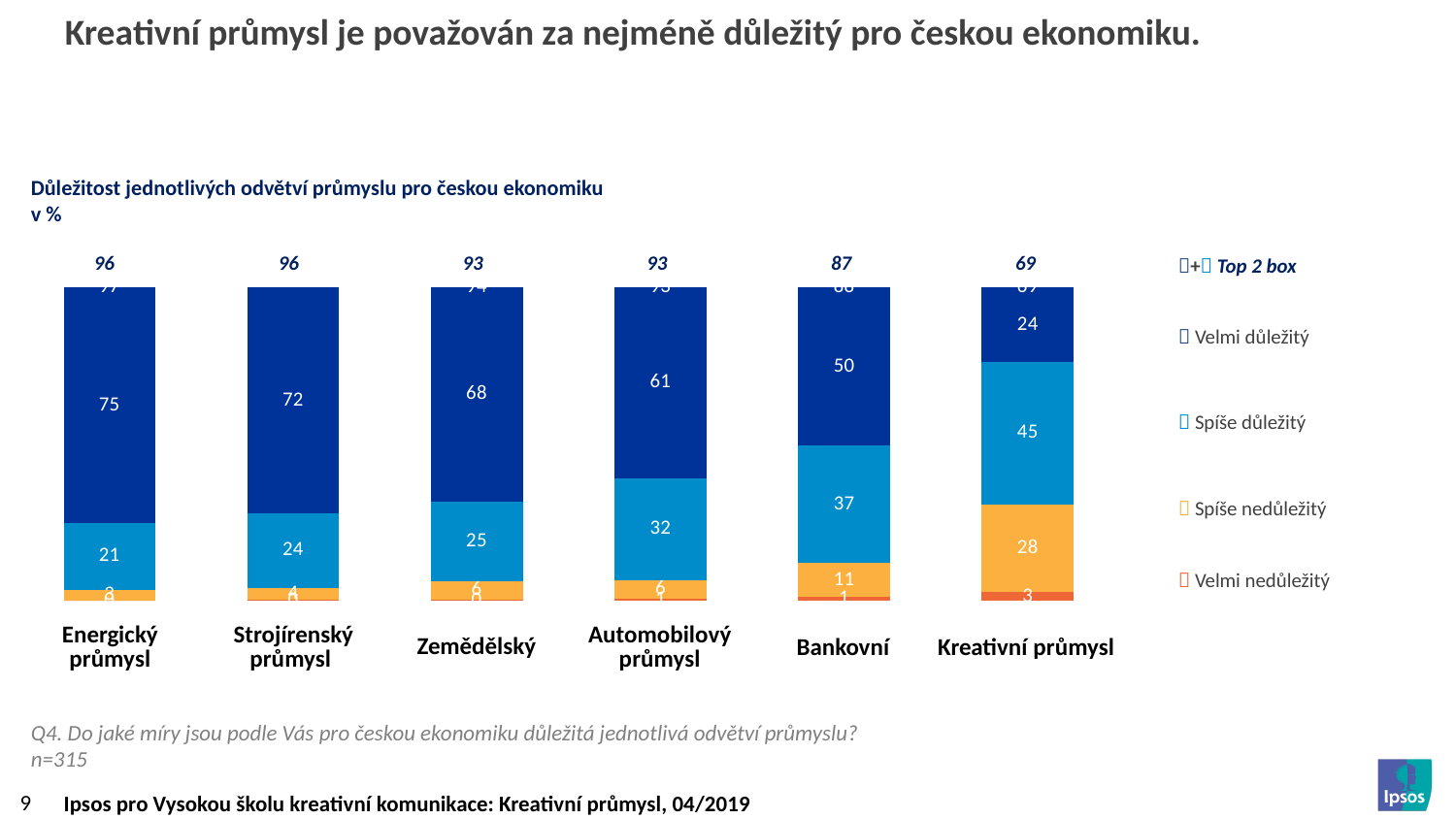
Which industry has the highest 'Spíše nedůležitý' value? Kreativní průmysl What is the 'Spíše nedůležitý' value for Bankovní? 11 Which industry has the lowest Top 2 box value? Kreativní průmysl Which has the larger 'Spíše důležitý' value, Bankovní or Automobilový průmysl? Bankovní What is the Top 2 box value shown above the Bankovní bar? 87 What is the difference between the 'Velmi důležitý' values for Energický průmysl and Kreativní průmysl? 51 What is the 'Velmi důležitý' value for Energický průmysl? 75 What is the 'Spíše důležitý' value for Kreativní průmysl? 45 How many industries are shown on the chart? 6 What kind of chart is shown on the slide? Stacked bar chart Do the 'Velmi důležitý' values rise or fall moving from left to right across the industries? Fall Which industry has the highest 'Velmi důležitý' value? Energický průmysl